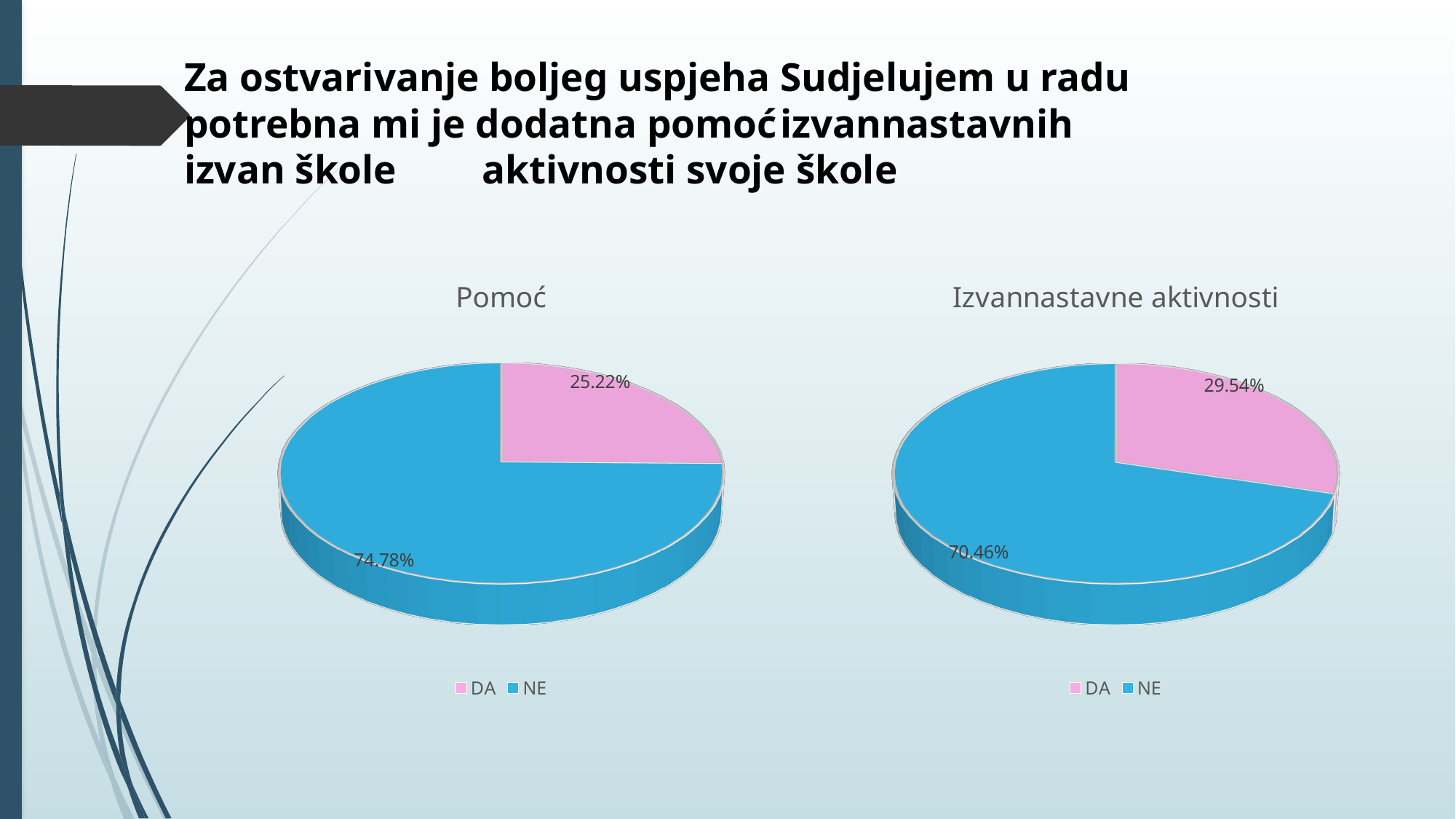
In the 'Izvannastavne aktivnosti' chart, what is the difference between the NE and DA percentages? 40.92% In the 'Pomoć' chart, which category has the largest slice? NE In the 'Pomoć' chart, what percentage is shown for NE? 74.78% How many categories does the legend of the 'Izvannastavne aktivnosti' chart list? 2 In the 'Pomoć' chart, what is the difference between the NE and DA percentages? 49.56% In the 'Pomoć' chart, what colour is the DA slice? Pink In the 'Pomoć' chart, what percentage is shown for DA? 25.22% Which chart has the larger DA share, 'Pomoć' or 'Izvannastavne aktivnosti'? Izvannastavne aktivnosti In the 'Izvannastavne aktivnosti' chart, which category has the smallest slice? DA In the 'Izvannastavne aktivnosti' chart, what percentage is shown for NE? 70.46% In the 'Izvannastavne aktivnosti' chart, what percentage is shown for DA? 29.54% What type of chart is the 'Pomoć' chart? Pie chart